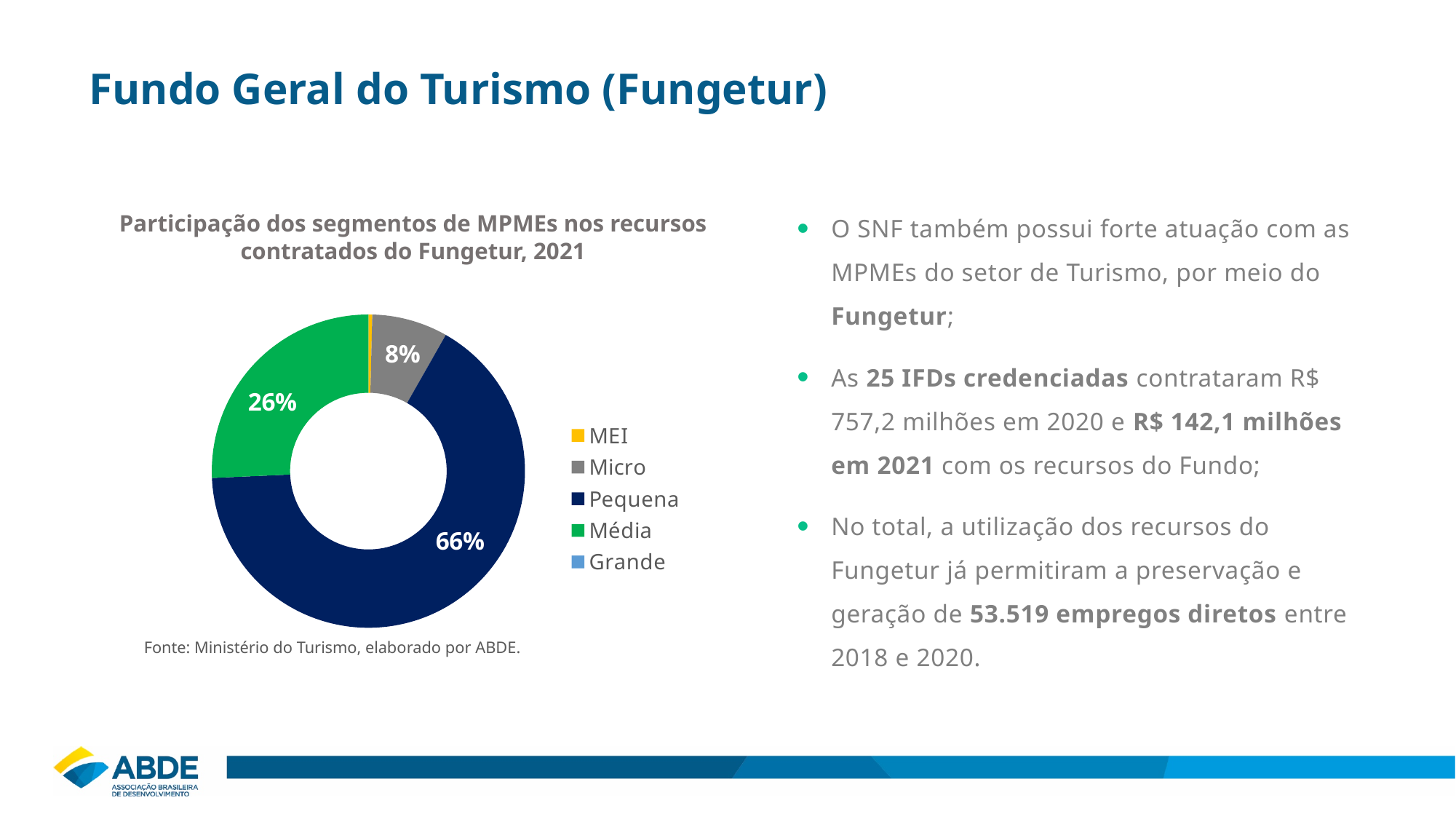
How many segments does the chart legend list? 5 What kind of chart is shown on the slide? Pie chart (donut) What share of Fungetur contracted resources went to the Pequena segment in 2021? 66% Which segment has the largest share of Fungetur contracted resources? Pequena What colour represents the Pequena segment in the chart? Dark blue How many percentage points larger is the Pequena share than the Média share? 40 percentage points Which segment has a larger share, Pequena or Média? Pequena What is the title of the chart? Participação dos segmentos de MPMEs nos recursos contratados do Fungetur, 2021 What share of Fungetur contracted resources went to the Micro segment? 8% How many percentage points larger is the Média share than the Micro share? 18 percentage points What share of Fungetur contracted resources went to the Média segment? 26% Which segment has a larger share, Média or Micro? Média